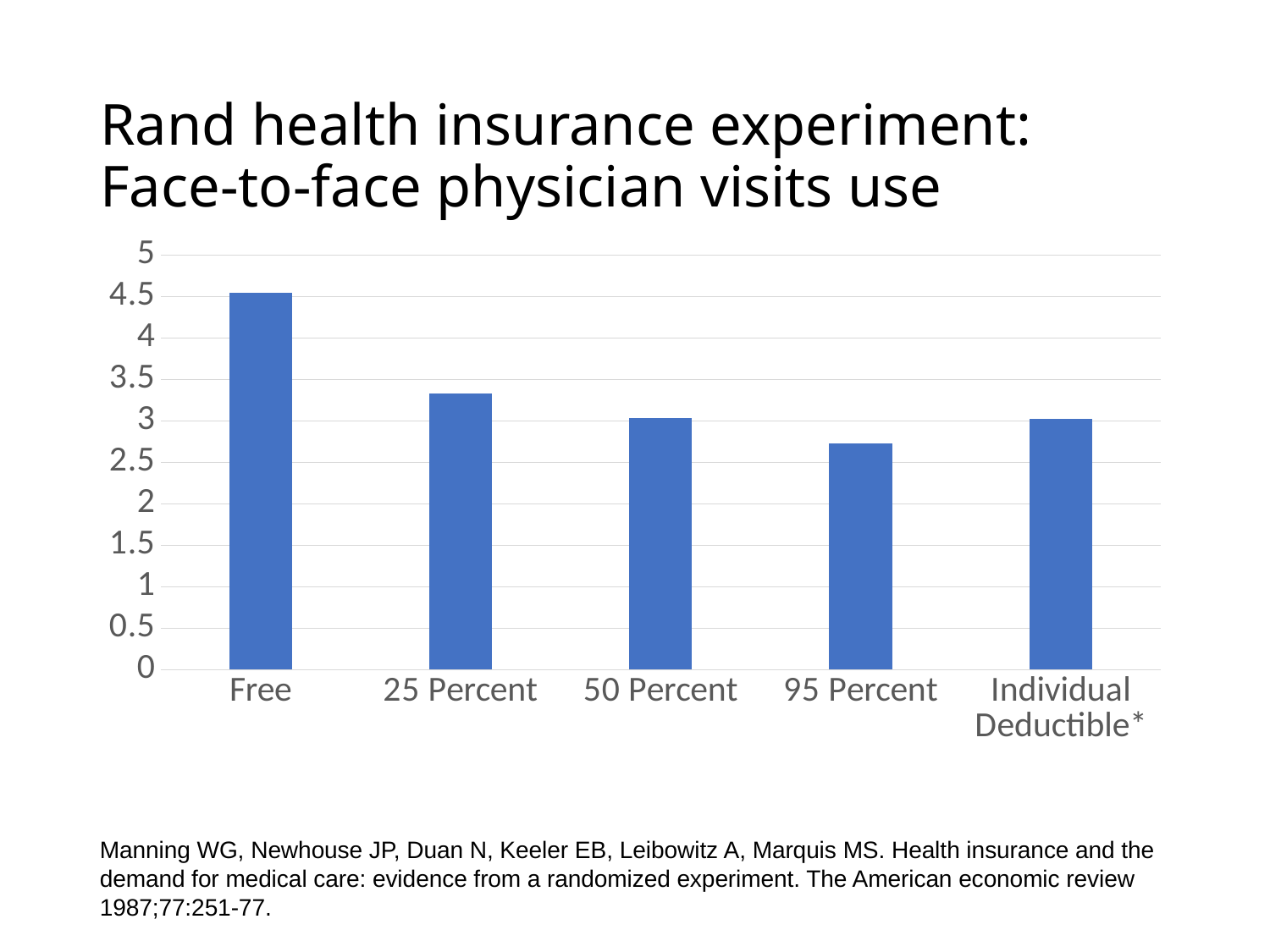
Do the values rise or fall from Free to 95 Percent along the x axis? fall Which category has the lowest value? 95 Percent How many categories are plotted on the x axis? 5 What kind of chart is shown on the slide? bar chart Is the value for 50 Percent greater or less than 3.5? less Which category has the highest value? Free Which is larger, the value for 25 Percent or the value for 95 Percent? 25 Percent Is the value for Free greater or less than 4? greater Is the value for 25 Percent greater or less than 3? greater Which is larger, the value for Free or the value for 25 Percent? Free